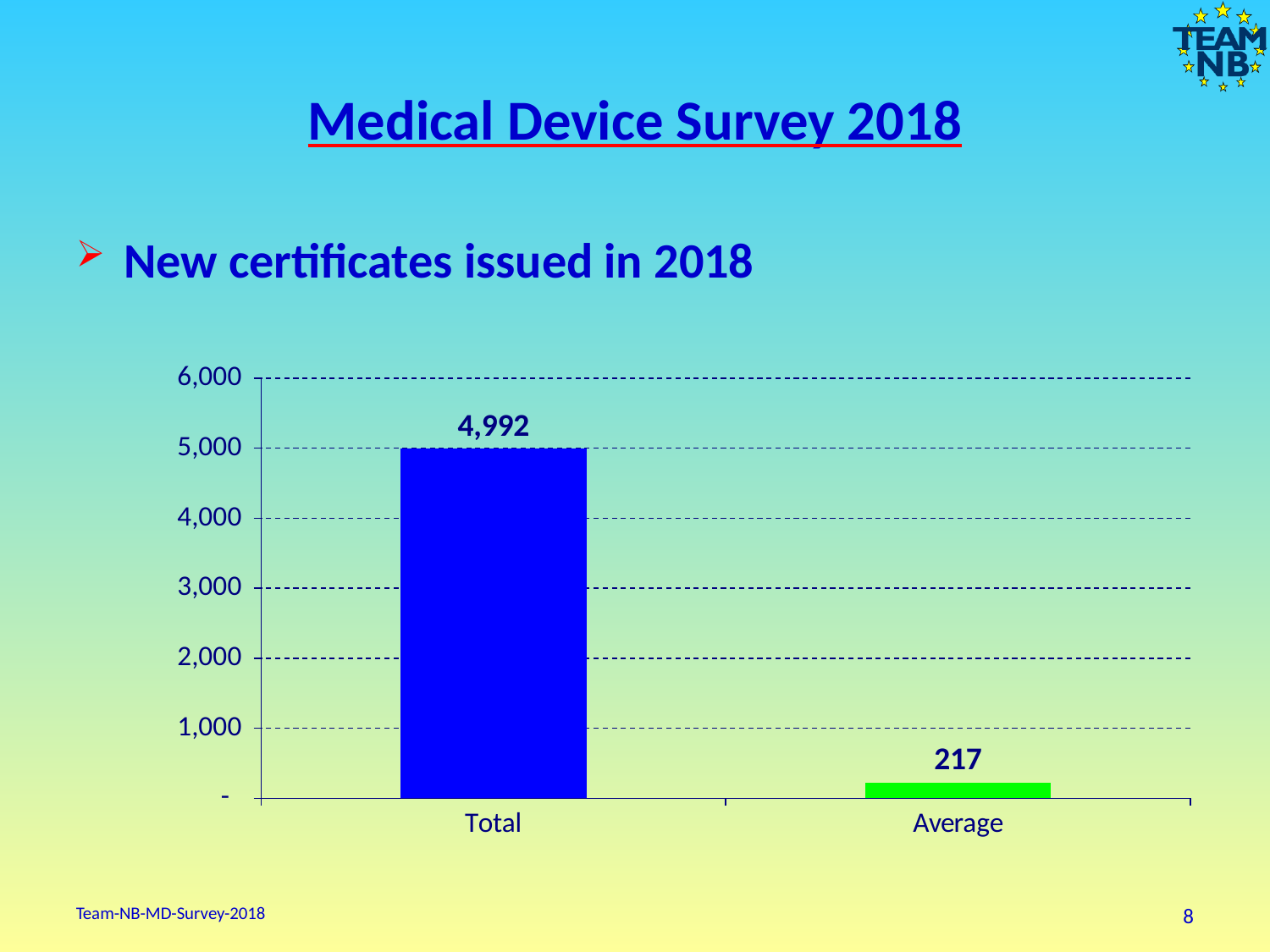
Which category has the lowest value? Average What colour is the bar for Total? blue What is the value for Total? 4,992 Which is larger, the value for Total or the value for Average? Total What kind of chart is shown on the slide? bar chart Which category has the highest value? Total What is the value for Average? 217 Is the value for Average greater or less than 1,000? less Is the value for Total greater or less than 4,000? greater How many categories are shown on the x axis? 2 What is the difference between the Total and Average values? 4,775 What is the highest value shown on the y axis? 6,000